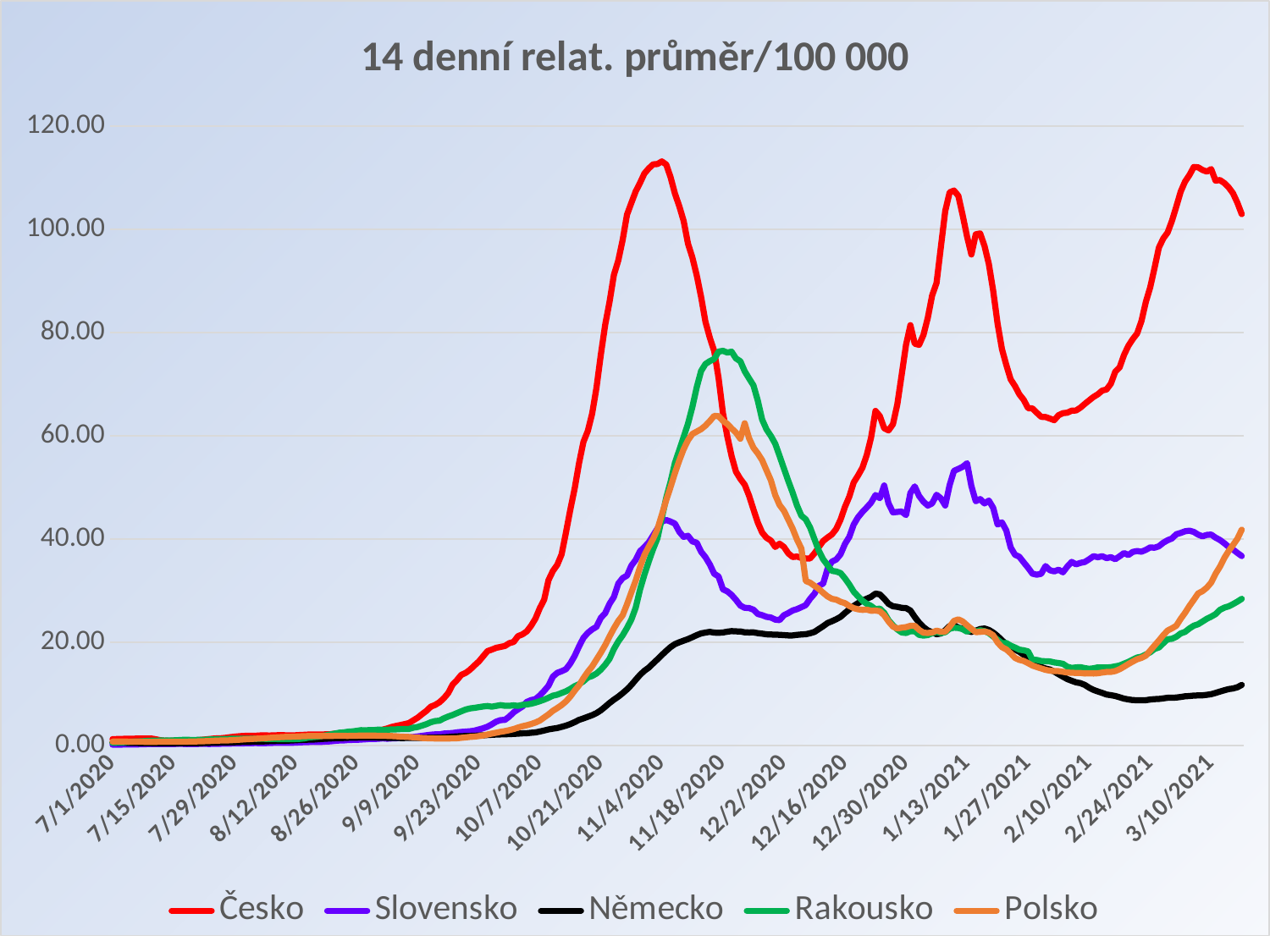
Is the peak value for Česko around 11/4/2020 greater or less than 100? greater What kind of chart is shown on the slide? line chart Which series reaches the highest value anywhere on the chart? Česko How many series does the legend list? 5 Is the peak value for Německo greater or less than 40? less Does the Německo line rise or fall between 1/13/2021 and 2/24/2021? fall Which series has the lowest value at the right end of the chart (around 3/10/2021)? Německo Is the peak value for Slovensko greater or less than 60? less Which series reaches a higher peak, Rakousko or Polsko? Rakousko What is the title of the chart? 14 denní relat. průměr/100 000 Which series is drawn in black? Německo